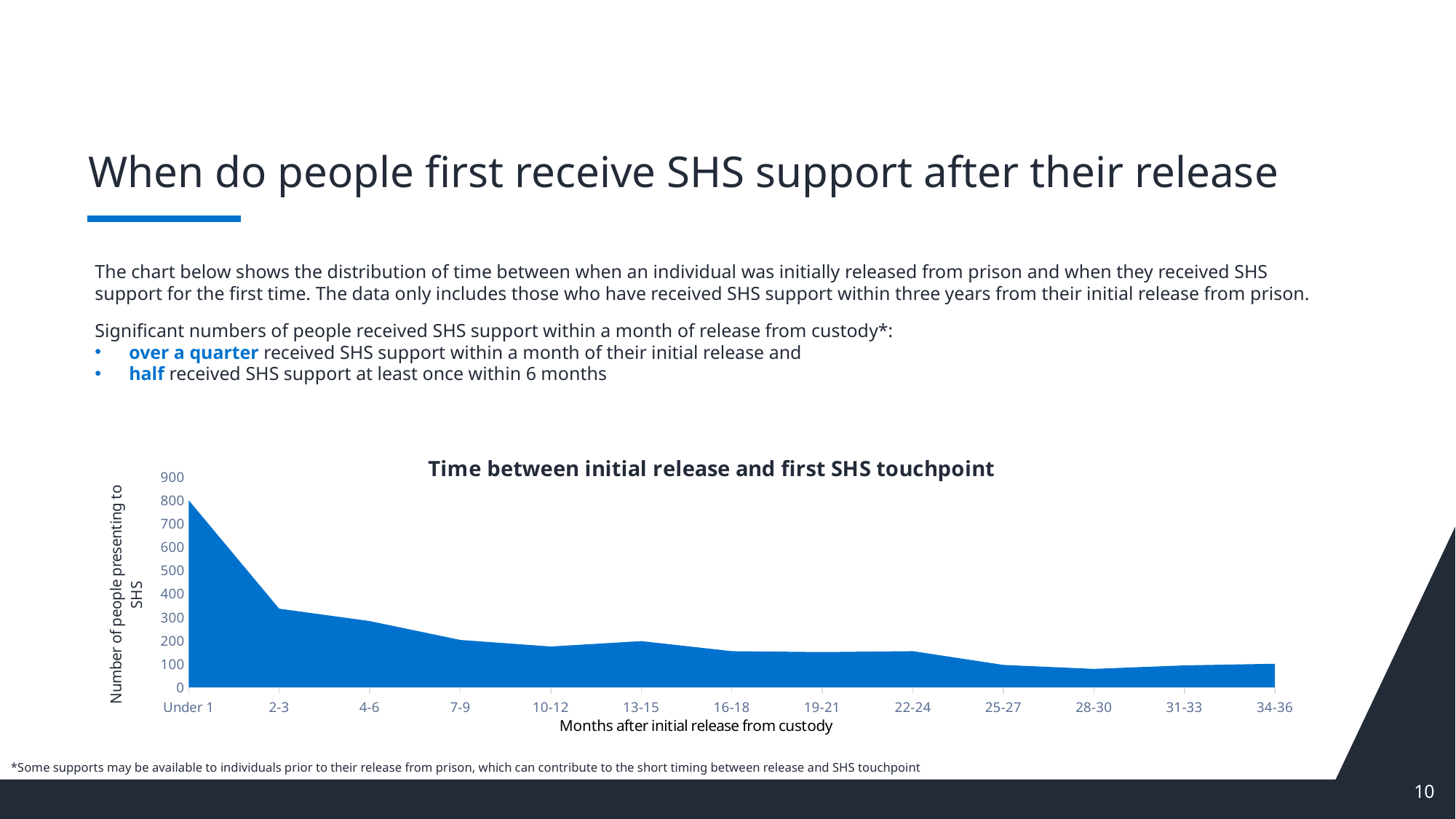
What is the title of the chart? Time between initial release and first SHS touchpoint Is the value for the 7-9 month range greater or less than 300? less Is the value for 'Under 1' month greater or less than 700? greater Which has more people presenting to SHS: the 4-6 month range or the 25-27 month range? 4-6 Which has more people presenting to SHS: the 'Under 1' month range or the 2-3 month range? Under 1 How many month-range categories are shown along the x axis of the chart? 13 Is the value for the 25-27 month range greater or less than 200? less Overall, do the values rise or fall as months after initial release increase? Fall What is the label of the x axis of the chart? Months after initial release from custody Which month range has the highest number of people presenting to SHS? Under 1 What kind of chart is shown on the slide? Area chart